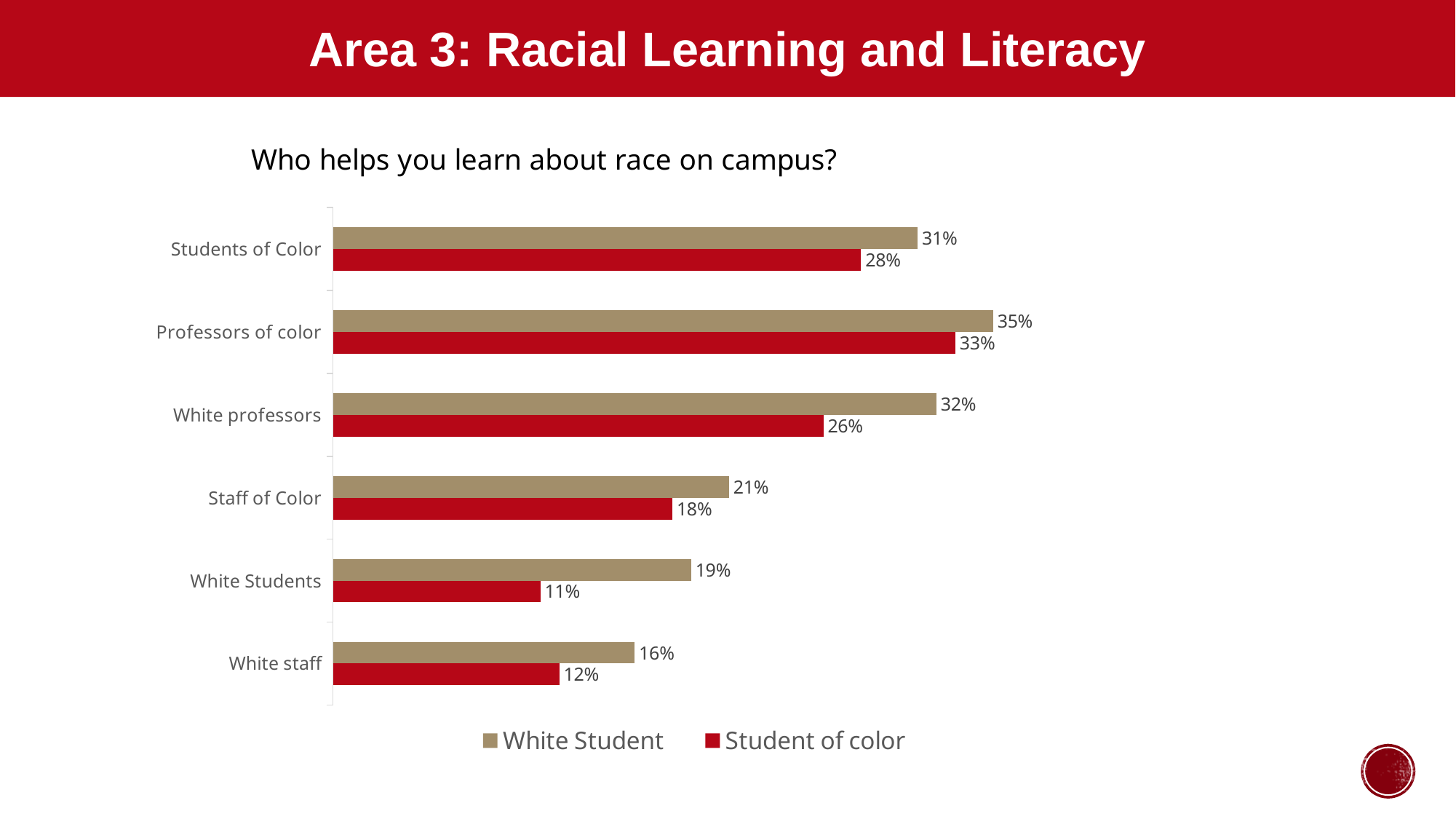
What percentage of Students of color said White Students help them learn about race on campus? 11% What kind of chart is shown on the slide? Bar chart What is the value for Student of color in the White professors category? 26% Which category has the lowest value for the Student of color series? White Students For Staff of Color, which series has the larger value, White Student or Student of color? White Student What is the difference between the White Student and Student of color values for Professors of color? 2% What is the difference between the White Student and Student of color values for White Students? 8% What percentage of White Students said Professors of color help them learn about race on campus? 35% How many categories are shown on the chart? 6 How many series does the legend list? 2 What is the title of the chart? Who helps you learn about race on campus? Which category has the highest value for the White Student series? Professors of color